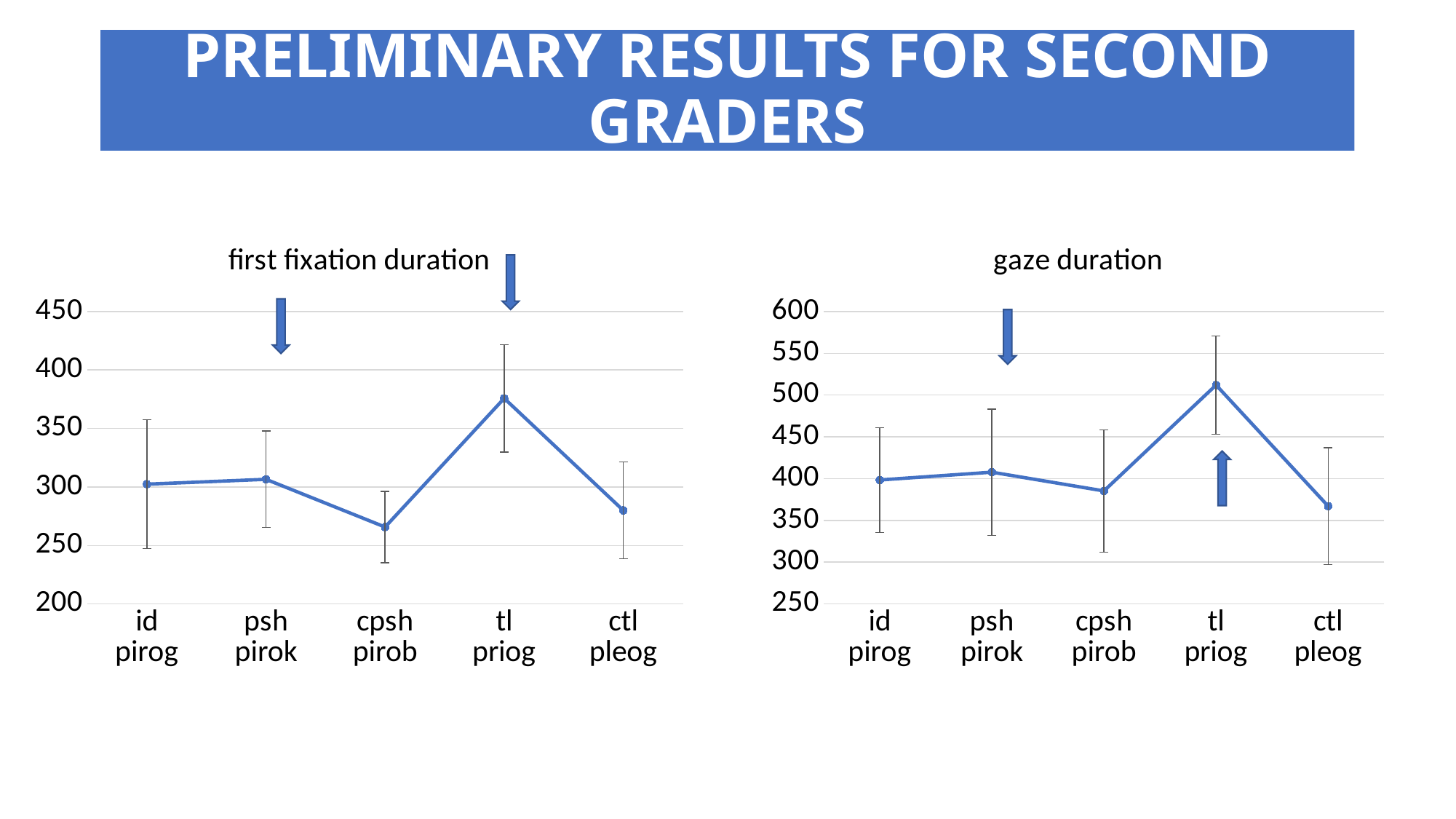
In the 'gaze duration' chart, is the value for ctl pleog greater or less than 400? less In the 'gaze duration' chart, which is larger, the value for tl priog or the value for cpsh pirob? tl priog In the 'gaze duration' chart, which category has the lowest value? ctl pleog In the 'gaze duration' chart, is the value for tl priog greater or less than 500? greater In the 'first fixation duration' chart, is the value for tl priog greater or less than 350? greater In the 'first fixation duration' chart, what kind of chart is shown? line chart In the 'gaze duration' chart, which category has the highest value? tl priog What is the title of the chart on the right side of the slide? gaze duration In the 'gaze duration' chart, how many categories are plotted along the x axis? 5 In the 'first fixation duration' chart, which category has the highest value? tl priog In the 'first fixation duration' chart, which category has the lowest value? cpsh pirob